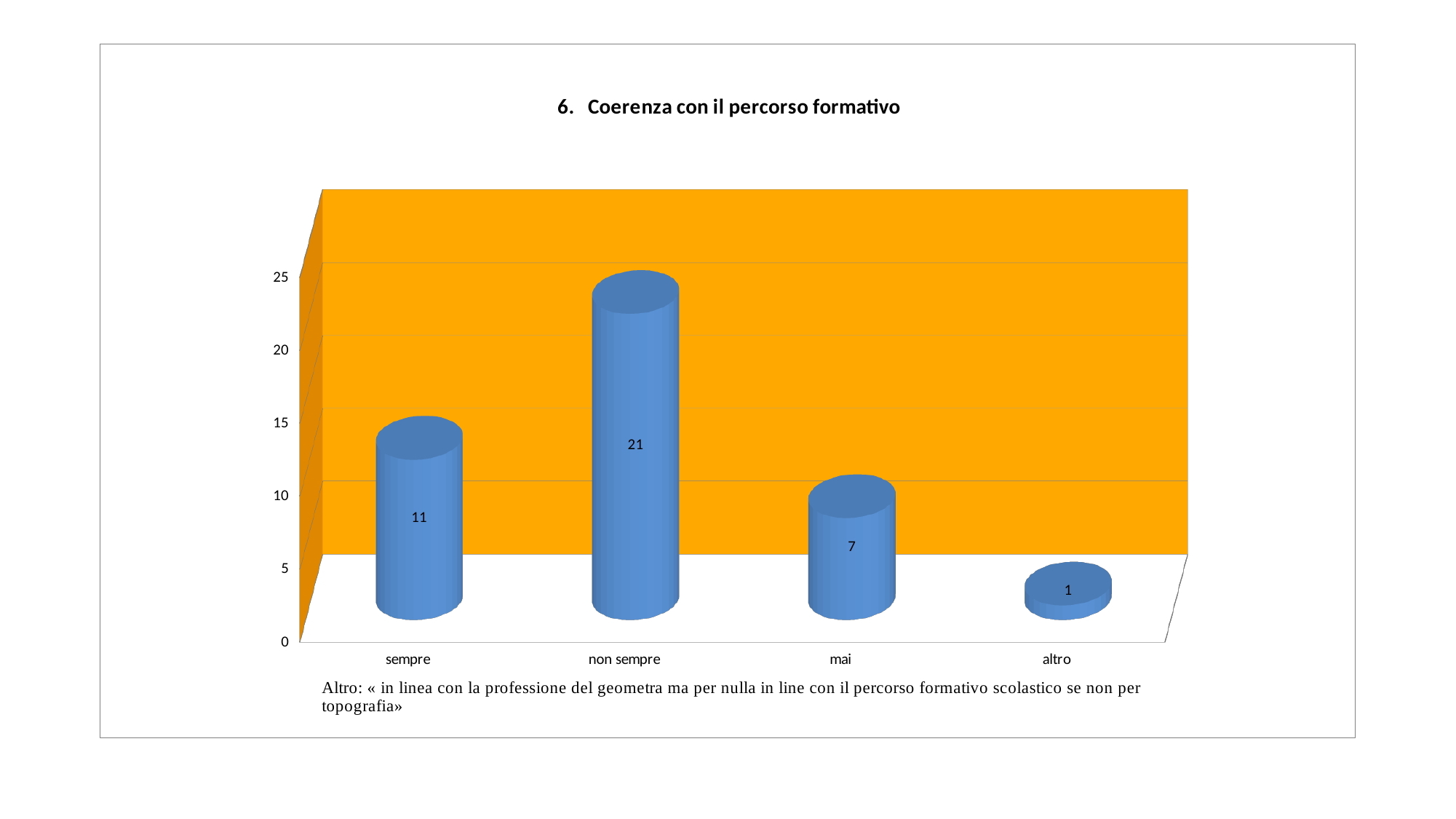
What is the title of the chart? 6. Coerenza con il percorso formativo What kind of chart is shown on the slide? bar chart Which is larger, the value for "sempre" or the value for "mai"? sempre How many categories are shown on the x axis? 4 Which category has the lowest value? altro What is the value for "sempre"? 11 What is the difference between the values for "mai" and "altro"? 6 What is the difference between the values for "non sempre" and "sempre"? 10 What is the value for "altro"? 1 Which category has the highest value? non sempre What is the value for "non sempre"? 21 What is the value for "mai"? 7